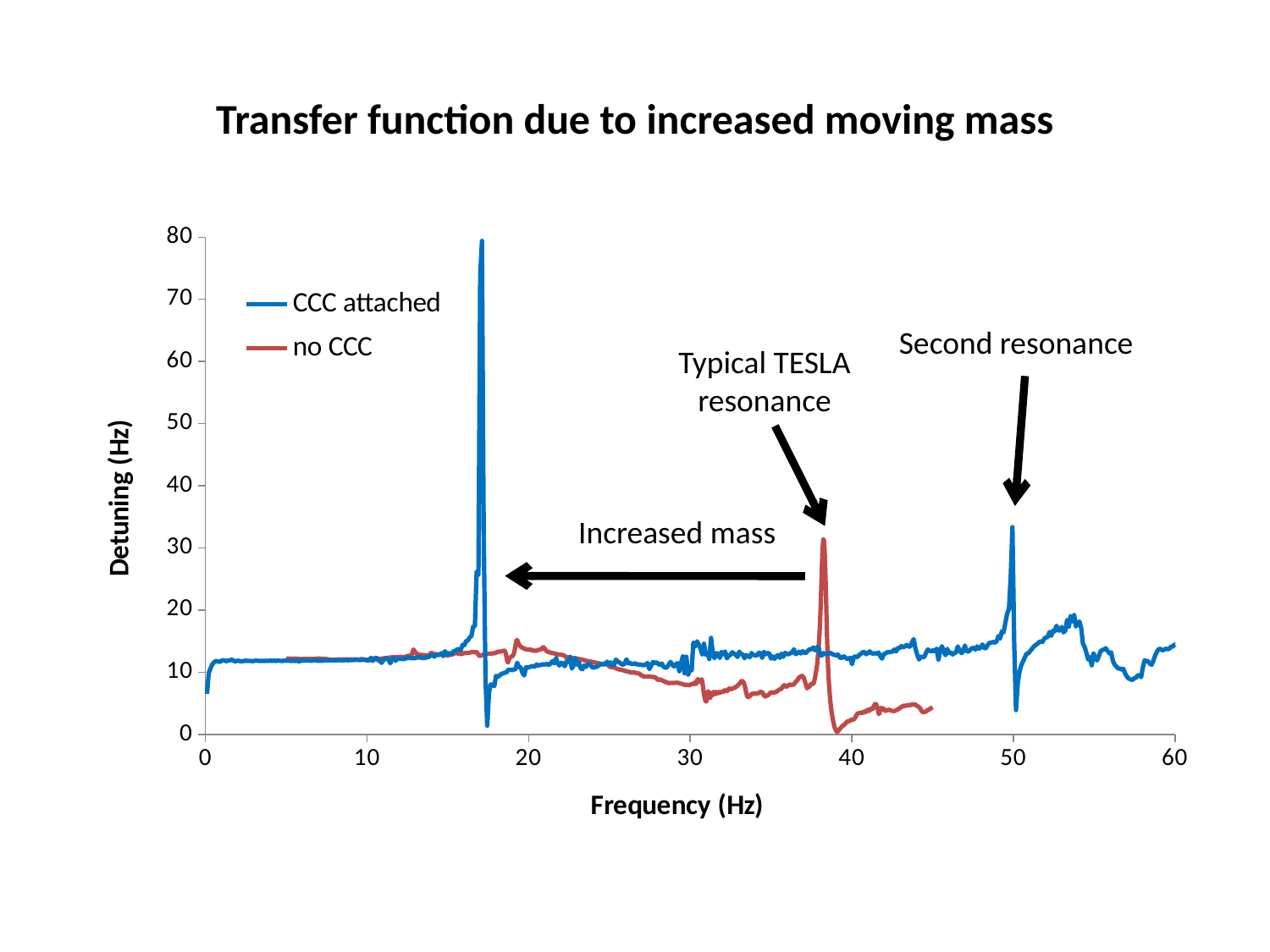
Is the peak value of the CCC attached series near 50 Hz greater or less than 20? greater What is the label of the x axis? Frequency (Hz) Is the peak value of the CCC attached series near 17 Hz greater or less than 70? greater Is the peak value of the no CCC series near 38 Hz greater or less than 20? greater Which series reaches the higher maximum detuning, CCC attached or no CCC? CCC attached Which series has its largest peak at the lower frequency, CCC attached or no CCC? CCC attached How many series does the legend list? 2 What is the title of the chart? Transfer function due to increased moving mass What kind of chart is shown on the slide? line chart